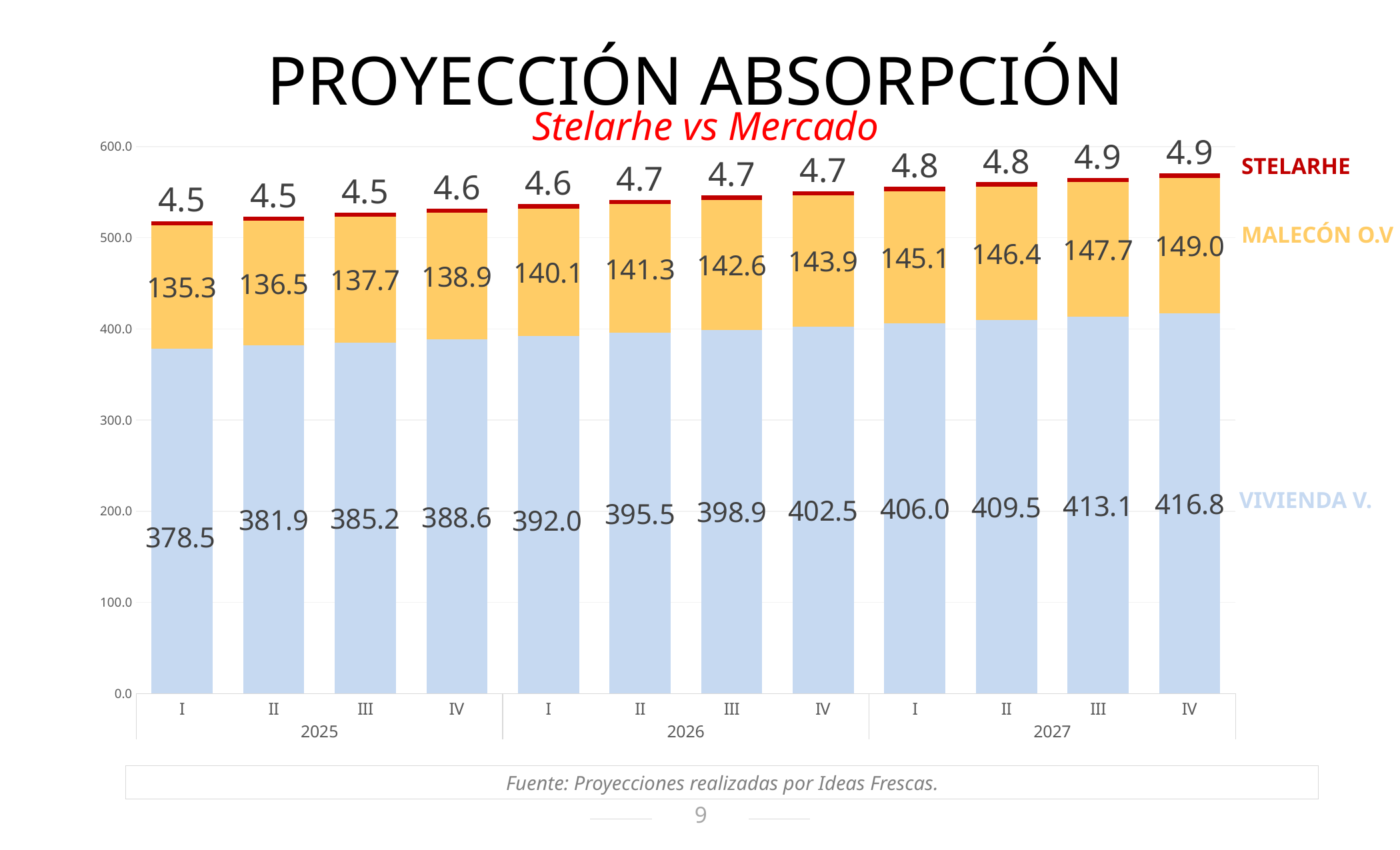
In which quarter is the MALECÓN O.V value lowest? I 2025 What kind of chart is shown on the slide? Stacked bar chart What is the difference between the VIVIENDA V. value in quarter IV of 2027 and quarter I of 2025? 38.3 Do the VIVIENDA V. values rise or fall from 2025 to 2027? Rise In which quarter is the VIVIENDA V. value highest? IV 2027 What is the STELARHE value for quarter II of 2026? 4.7 What is the VIVIENDA V. value for quarter I of 2025? 378.5 What is the subtitle shown in red below the chart title? Stelarhe vs Mercado What is the MALECÓN O.V value for quarter IV of 2027? 149.0 How many series does the chart's legend list? 3 How many quarterly bars are plotted in the chart? 12 What is the total of the stacked bar for quarter I of 2025? 518.3